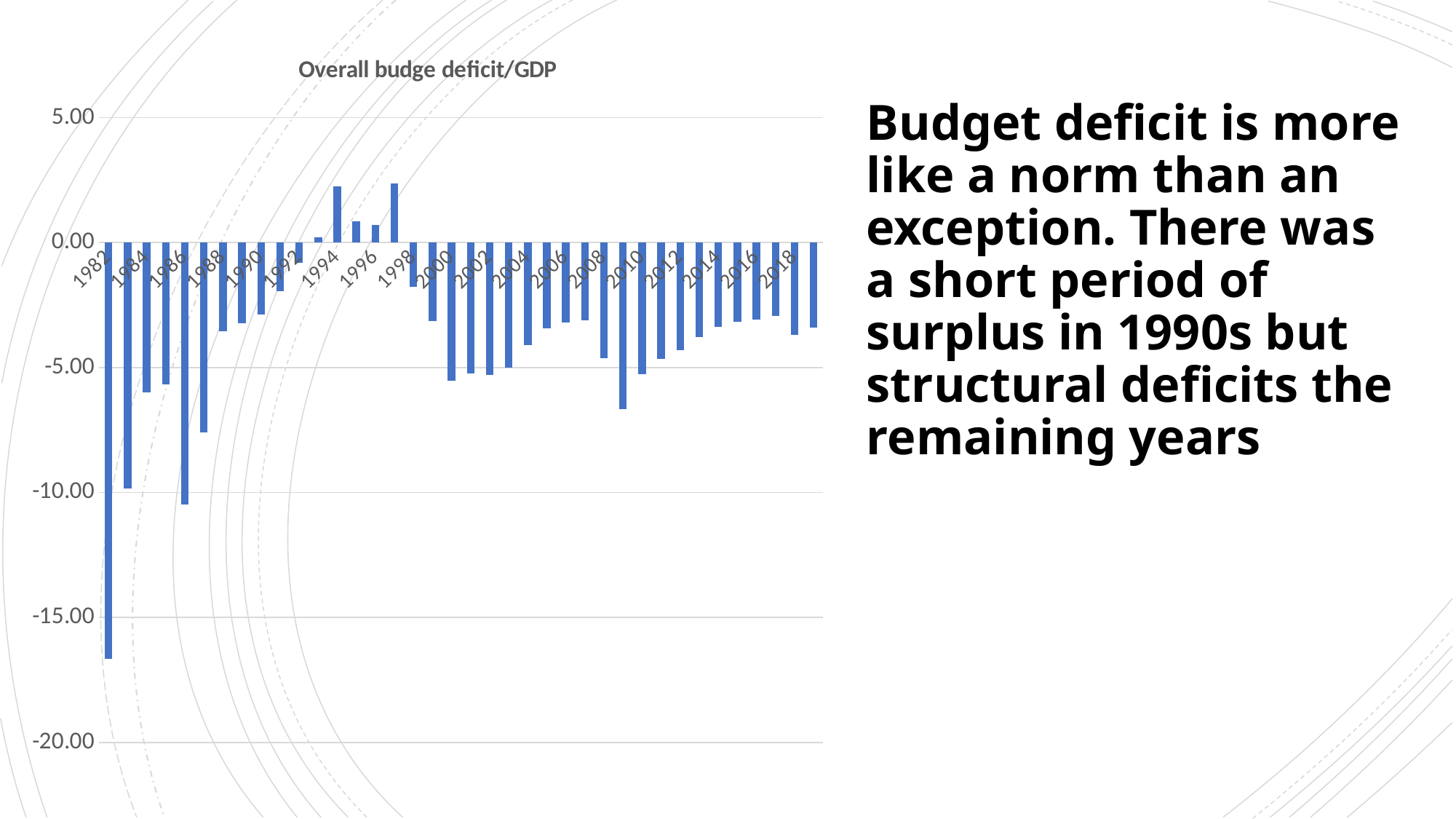
Is the value for 1986 greater or less than -10.00? less What kind of chart is shown on the slide? bar chart Which is larger, the value for 1982 or the value for 1986? 1986 Is the value for 2004 greater or less than -5.00? greater Is the value for 1982 greater or less than -15.00? less What is the title of the chart? Overall budge deficit/GDP Which is larger, the value for 2009 or the value for 2006? 2006 Do the values generally rise or fall from 1982 to 1992? rise Which year has the lowest value in the chart? 1982